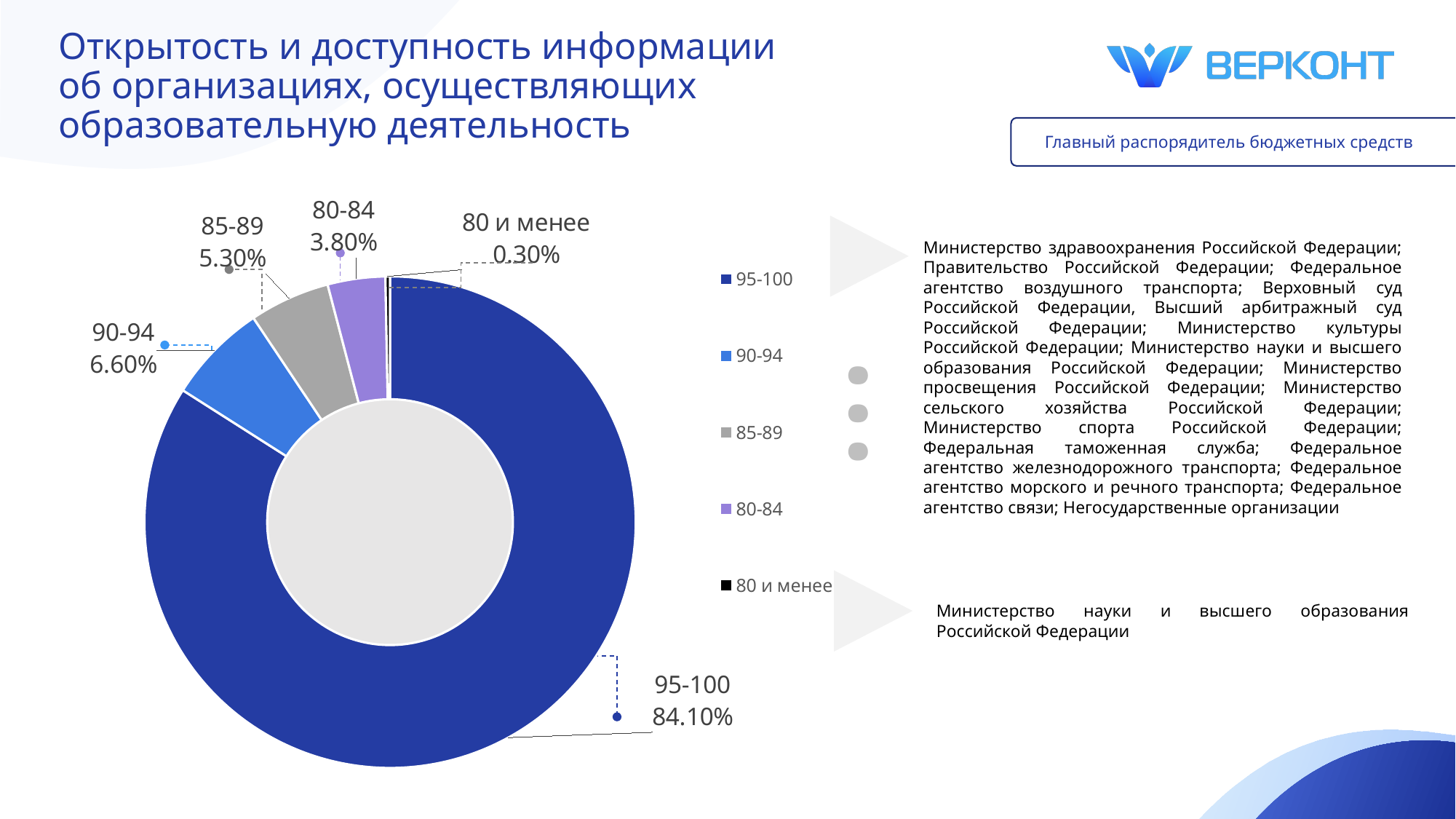
Which category has the smallest share of the chart? 80 и менее Which category has the largest share of the chart? 95-100 What is the value for the 95-100 category? 84.10% What is the value for the 80-84 category? 3.80% What kind of chart is shown on the slide? Doughnut (pie) chart What is the difference between the 90-94 and 85-89 shares? 1.30% What colour is the 90-94 segment of the chart? Light blue Which is larger, the share for 80-84 or the share for 85-89? 85-89 What is the value for the '80 и менее' category? 0.30% What is the value for the 90-94 category? 6.60% What is the value for the 85-89 category? 5.30% How many categories does the chart show? 5